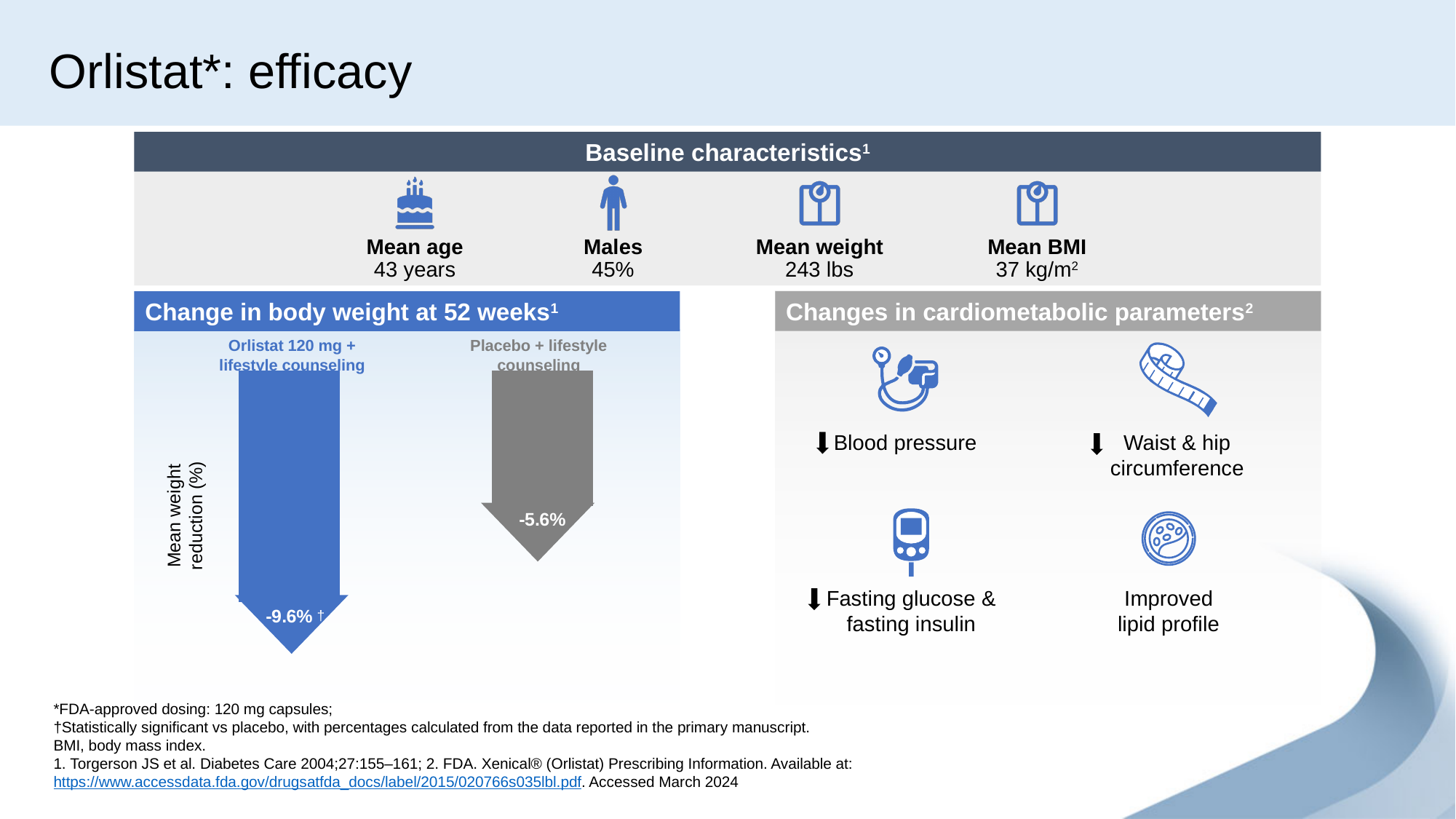
In the 'Change in body weight at 52 weeks' chart, which group shows the smaller mean weight reduction? Placebo + lifestyle counseling In the 'Change in body weight at 52 weeks' chart, what colour is the arrow for the Orlistat 120 mg + lifestyle counseling group? Blue In the 'Change in body weight at 52 weeks' chart, is the weight reduction greater for the Orlistat group or the Placebo group? Orlistat group What is the label on the vertical axis of the 'Change in body weight at 52 weeks' chart? Mean weight reduction (%) In the 'Change in body weight at 52 weeks' chart, what is the mean weight reduction for Placebo + lifestyle counseling? -5.6% In the 'Change in body weight at 52 weeks' chart, which group's value is marked with a dagger (†) indicating statistical significance vs placebo? Orlistat 120 mg + lifestyle counseling In the 'Change in body weight at 52 weeks' chart, what is the mean weight reduction for Orlistat 120 mg + lifestyle counseling? -9.6% In the 'Change in body weight at 52 weeks' chart, which group shows the larger mean weight reduction? Orlistat 120 mg + lifestyle counseling In the 'Change in body weight at 52 weeks' chart, by how many percentage points does the weight reduction for Orlistat 120 mg + lifestyle counseling exceed that for Placebo + lifestyle counseling? 4.0% How many treatment groups are shown in the 'Change in body weight at 52 weeks' chart? 2